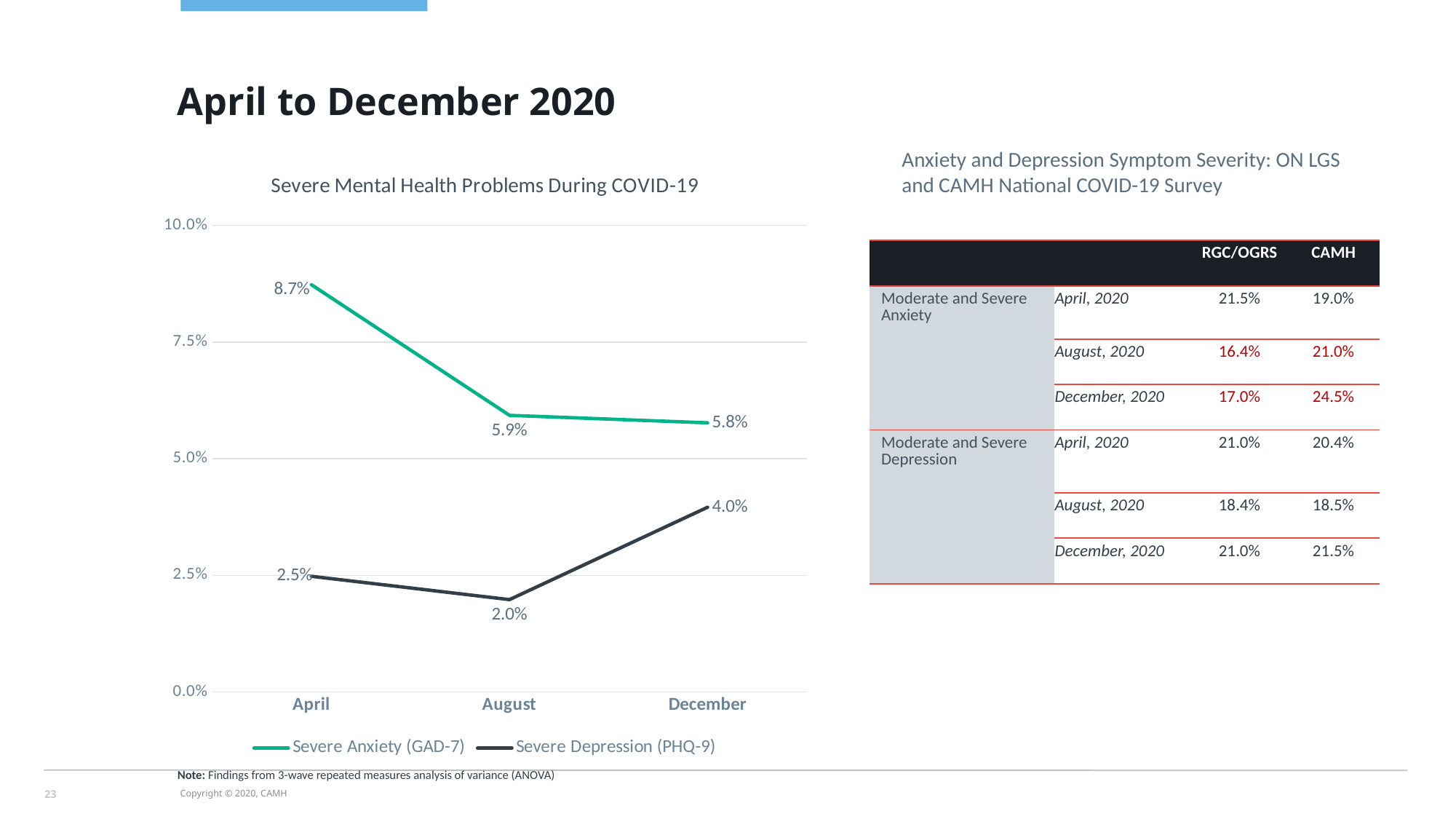
What kind of chart is shown on the slide? Line chart Does Severe Anxiety (GAD-7) rise or fall from April to December? Fall What is the difference between Severe Depression (PHQ-9) in December and in August? 2.0% In which month is Severe Depression (PHQ-9) lowest? August How many months are shown on the x axis of the chart? 3 What is the difference between Severe Anxiety (GAD-7) in April and in August? 2.8% In which month is Severe Anxiety (GAD-7) highest? April Which is larger in December: Severe Anxiety (GAD-7) or Severe Depression (PHQ-9)? Severe Anxiety (GAD-7) What is the value for Severe Depression (PHQ-9) in August? 2.0% What is the value for Severe Anxiety (GAD-7) in April? 8.7% What is the value for Severe Anxiety (GAD-7) in December? 5.8% How many series does the chart legend list? 2